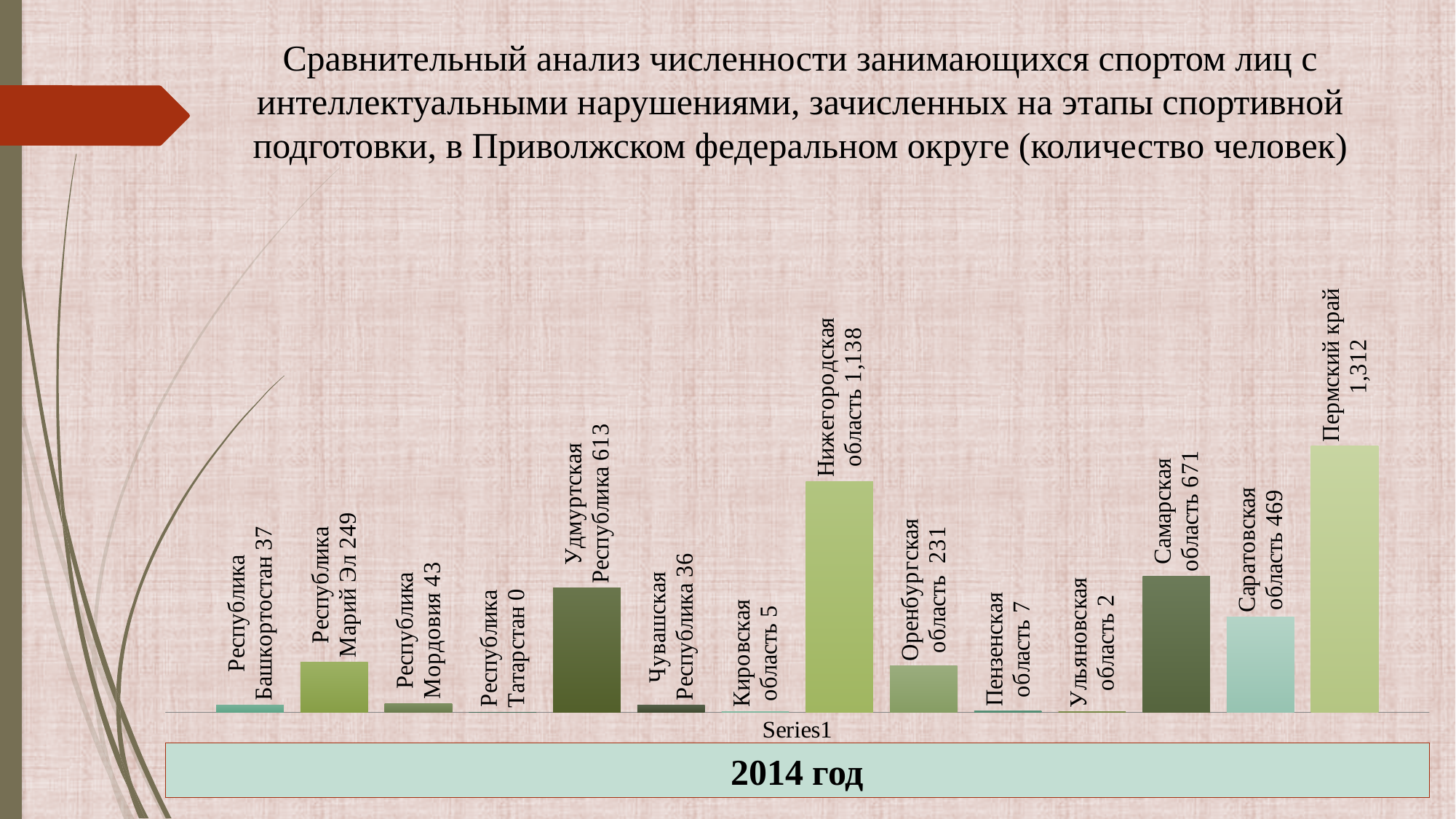
Which region has the lowest value? Республика Татарстан What is the value for Нижегородская область? 1,138 Which year is the chart labelled with below the axis? 2014 год What is the value for Республика Татарстан? 0 What is the difference between the values for Самарская область and Саратовская область? 202 Which is larger, the value for Республика Марий Эл or the value for Оренбургская область? Республика Марий Эл What kind of chart is shown on the slide? Bar chart What is the value for Удмуртская Республика? 613 What is the difference between the values for Пермский край and Нижегородская область? 174 What is the value for Пермский край? 1,312 Which region has the highest value? Пермский край How many regions are shown in the chart? 14